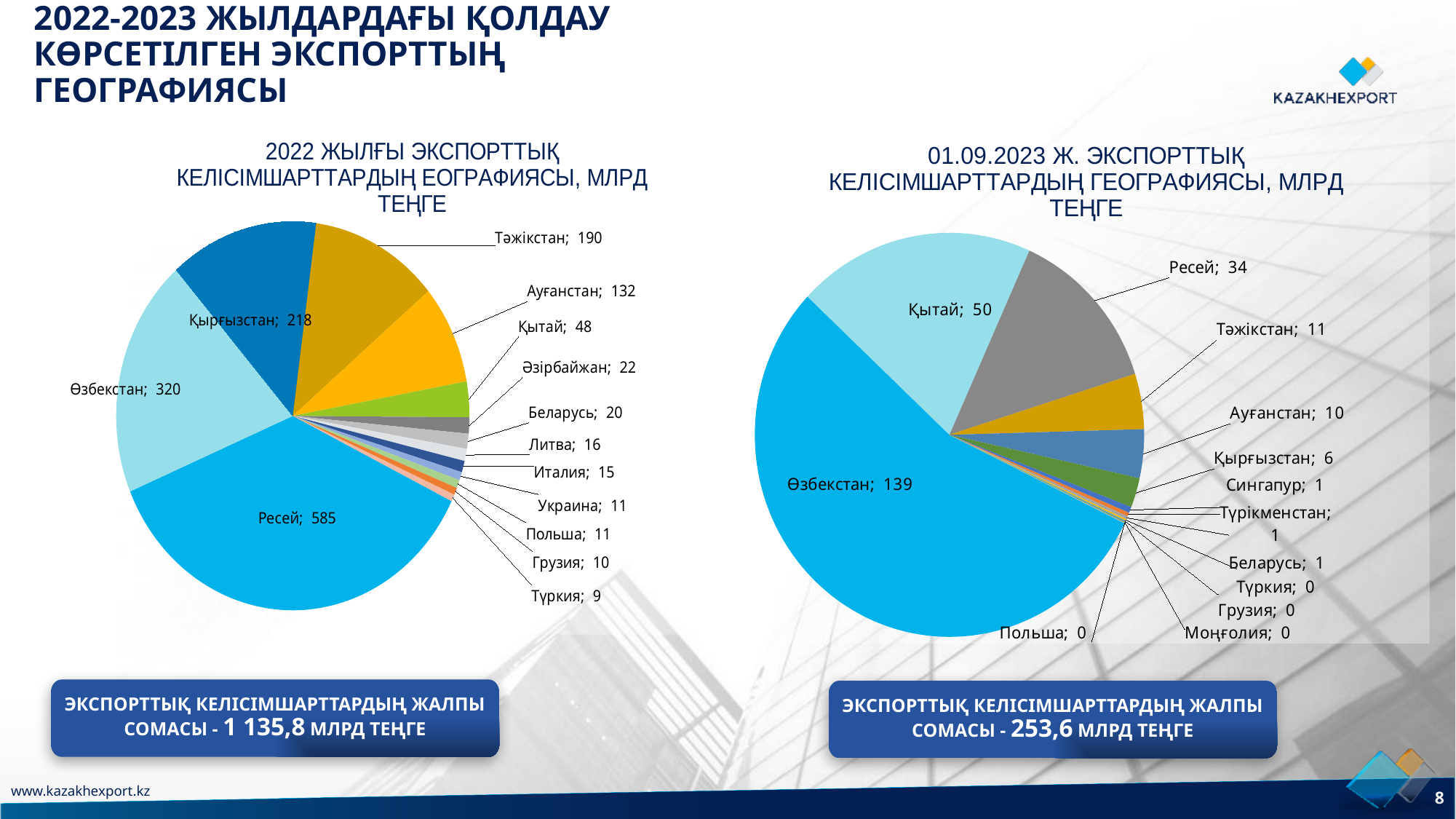
In the 2022 chart on the left, which country has the largest slice? Ресей In the 01.09.2023 chart on the right, which country has the largest slice? Өзбекстан In the 2022 chart on the left, which country has the smallest value? Түркия In the 01.09.2023 chart on the right, what is the value for Қытай? 50 In the 2022 chart on the left, what is the value for Ресей? 585 What type of chart is used on the left for the 2022 data? Pie chart How many countries are shown in the 01.09.2023 chart on the right? 13 In the 01.09.2023 chart on the right, what is the value for Тәжікстан? 11 In the 2022 chart on the left, what is the difference between the values for Ресей and Өзбекстан? 265 In the 01.09.2023 chart on the right, what is the difference between the values for Өзбекстан and Қытай? 89 In the 2022 chart on the left, which is larger: the value for Тәжікстан or the value for Ауғанстан? Тәжікстан In the 2022 chart on the left, what is the value for Қырғызстан? 218